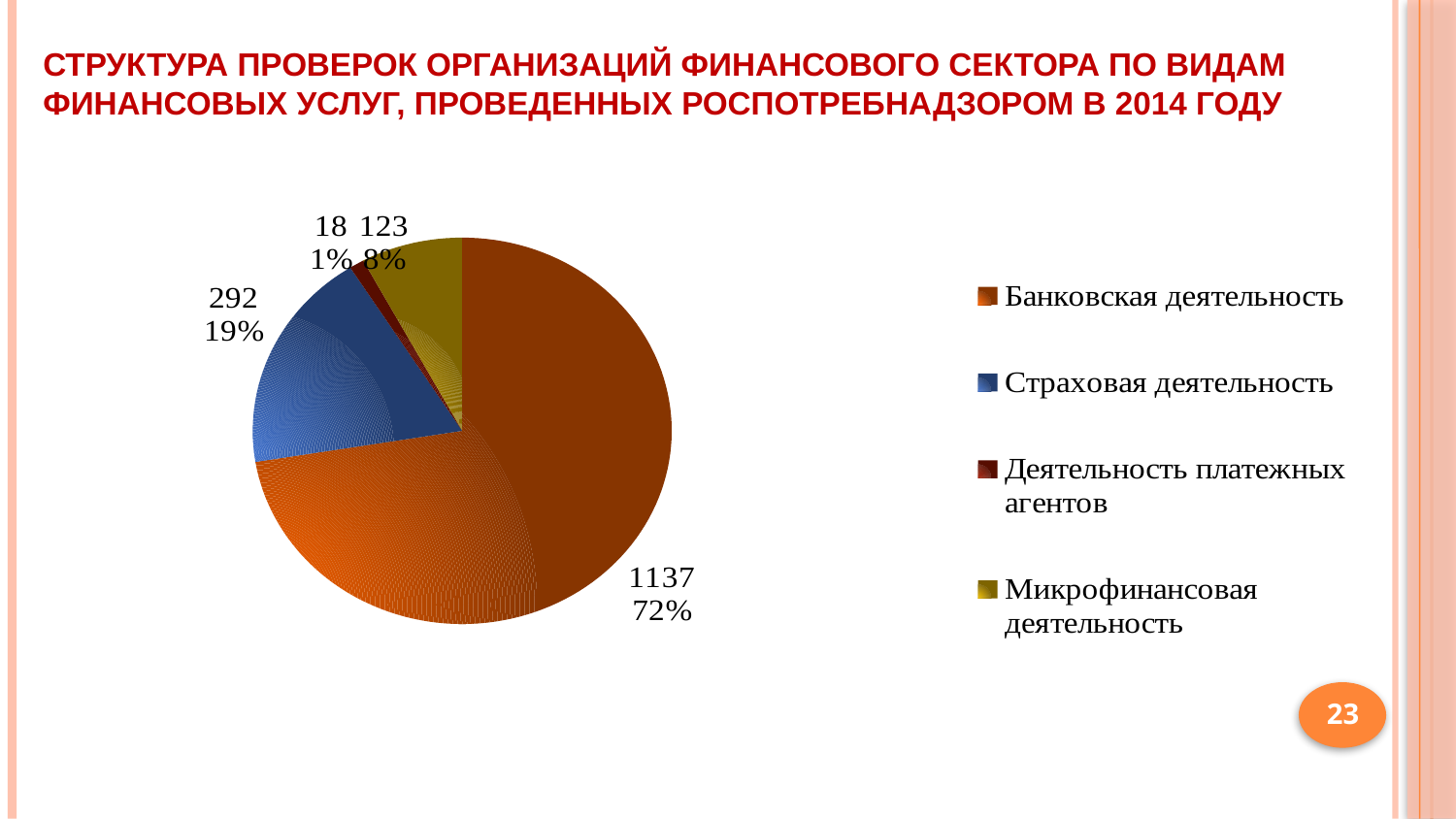
What is the value for Микрофинансовая деятельность? 123 What is the value for Деятельность платежных агентов? 18 What is the value for Страховая деятельность? 292 What share of the pie does Страховая деятельность take? 19% What kind of chart is shown on the slide? pie chart How many slices does the pie chart have? 4 What is the difference between the values for Страховая деятельность and Микрофинансовая деятельность? 169 Which category has the largest slice? Банковская деятельность How many entries does the legend list? 4 Which category has the smallest slice? Деятельность платежных агентов What is the value for Банковская деятельность? 1137 What share of the pie does Банковская деятельность take? 72%